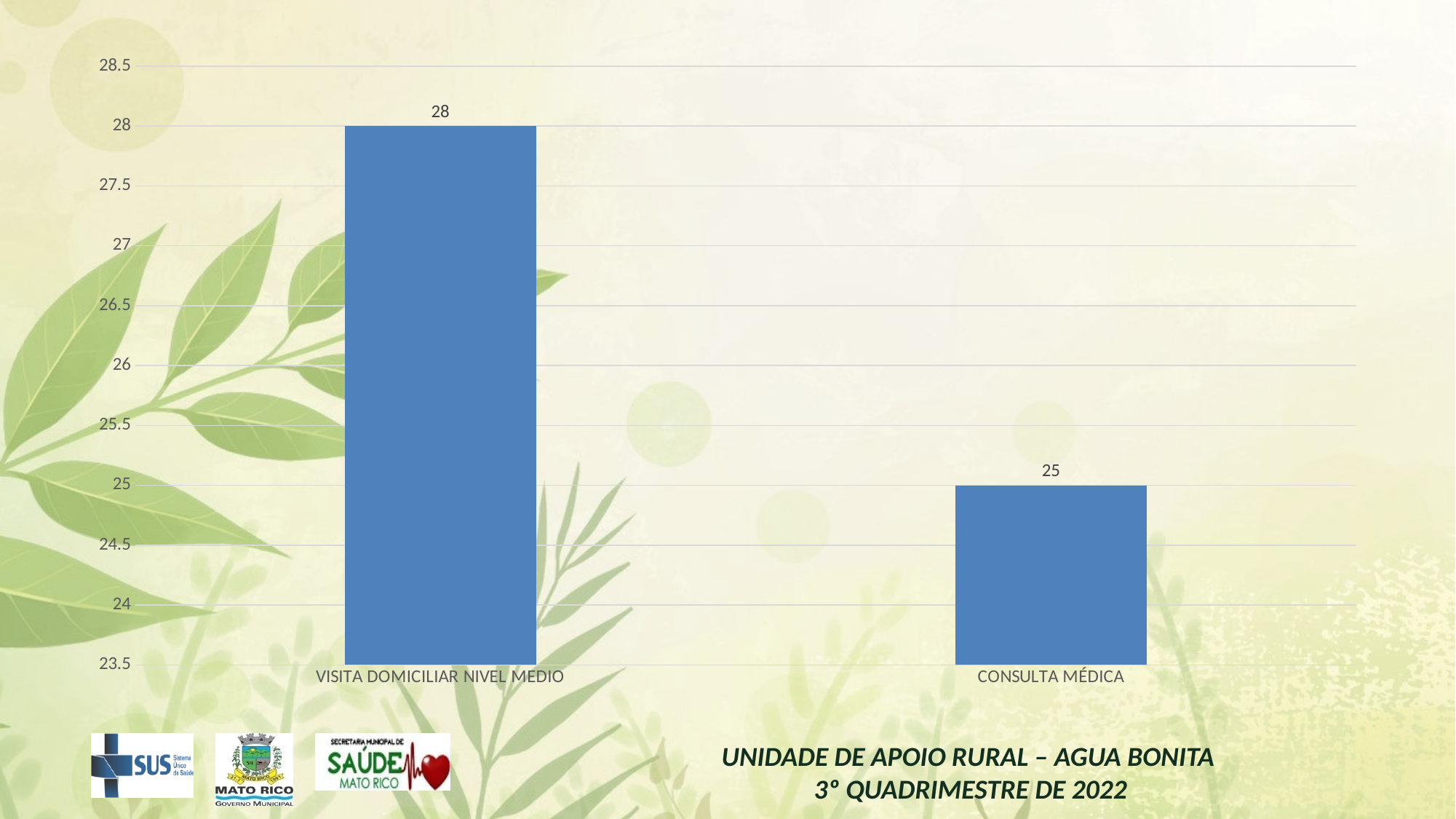
What is the value for CONSULTA MÉDICA? 25 Which category has the lowest value? CONSULTA MÉDICA How many categories are shown in the chart? 2 Which category has the highest value? VISITA DOMICILIAR NIVEL MEDIO What is the lowest value shown on the vertical axis? 23.5 What kind of chart is shown on the slide? bar chart Which is larger, the value for VISITA DOMICILIAR NIVEL MEDIO or the value for CONSULTA MÉDICA? VISITA DOMICILIAR NIVEL MEDIO What is the highest value shown on the vertical axis? 28.5 Is the value for CONSULTA MÉDICA greater or less than 26? less What is the difference between the values for VISITA DOMICILIAR NIVEL MEDIO and CONSULTA MÉDICA? 3 Is the value for VISITA DOMICILIAR NIVEL MEDIO greater or less than 27? greater What is the value for VISITA DOMICILIAR NIVEL MEDIO? 28